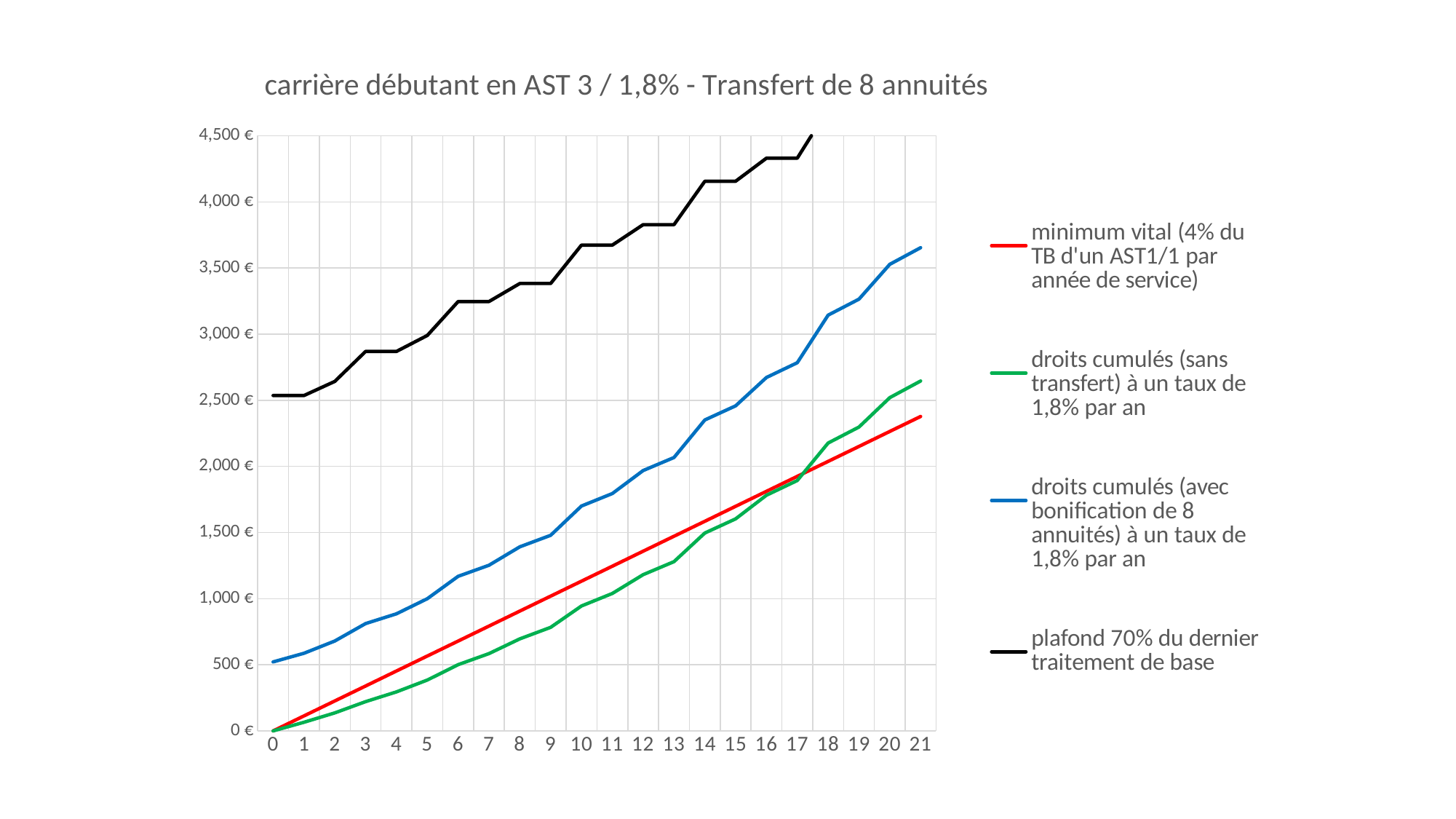
What kind of chart is shown on the slide? line chart What is the title of the chart? carrière débutant en AST 3 / 1,8% - Transfert de 8 annuités How many points are marked on the x axis (from 0 to 21)? 22 Is the value of 'droits cumulés (avec bonification de 8 annuités)' at year 21 greater or less than 3,500 €? greater At year 21, which is larger: 'droits cumulés (avec bonification de 8 annuités)' or 'droits cumulés (sans transfert)'? droits cumulés (avec bonification de 8 annuités) à un taux de 1,8% par an Which series has the highest value at year 10? plafond 70% du dernier traitement de base At year 5, which is larger: 'minimum vital' or 'droits cumulés (sans transfert)'? minimum vital (4% du TB d'un AST1/1 par année de service) Is the value of 'minimum vital' at year 21 greater or less than 2,500 €? less What colour is the line for 'plafond 70% du dernier traitement de base'? black Which series has the lowest value at year 5? droits cumulés (sans transfert) à un taux de 1,8% par an Does the 'plafond 70% du dernier traitement de base' line rise or fall from year 0 to year 21? rise How many series does the legend list? 4